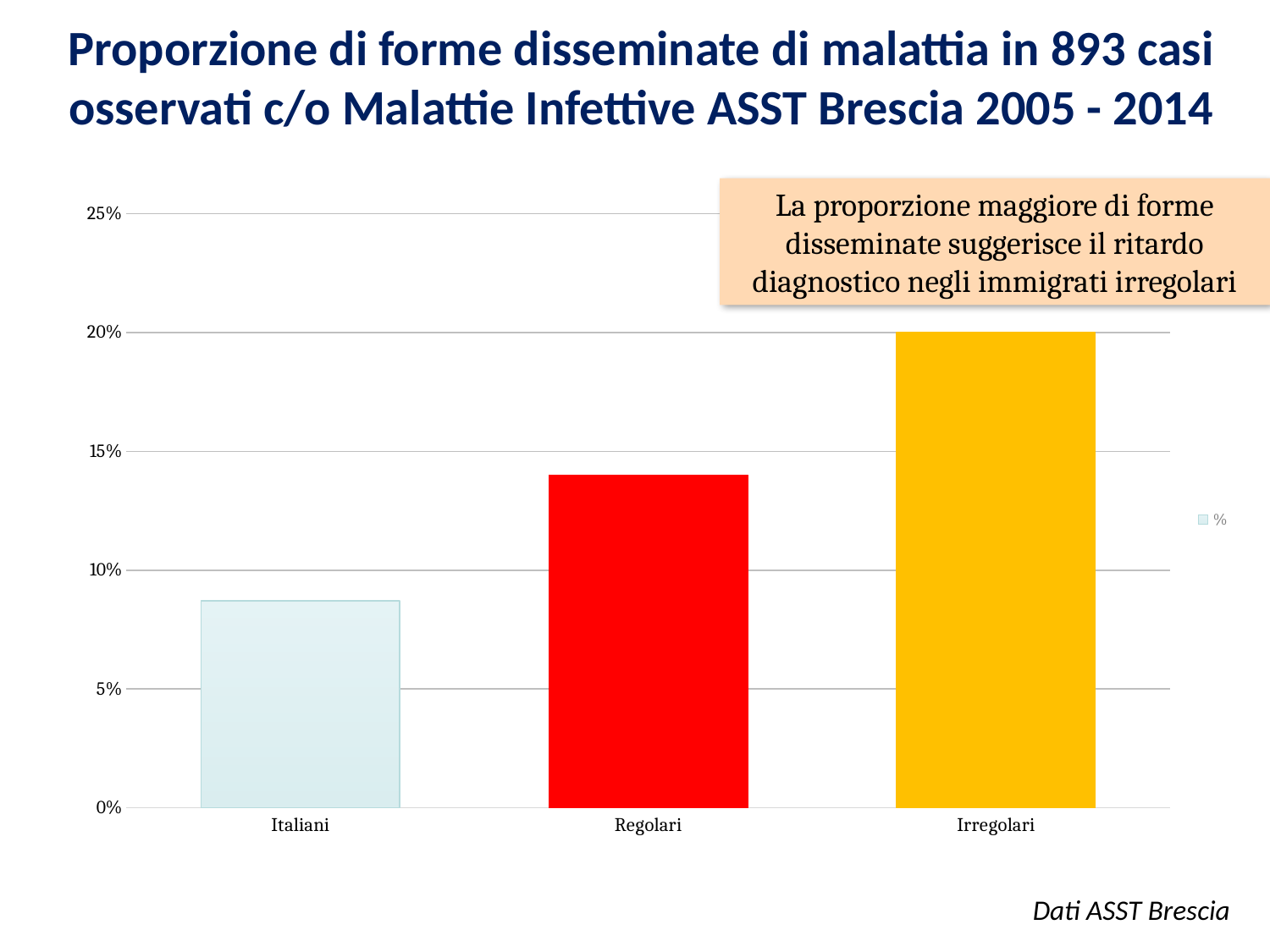
What kind of chart is shown on the slide? bar chart Which is larger, the value for Regolari or the value for Italiani? Regolari What is the value for Irregolari? 20% Do the bar values rise or fall from left to right along the x axis? rise Is the value for Regolari greater or less than 10%? greater Which category has the highest bar? Irregolari How many categories are plotted on the x axis? 3 Is the value for Italiani greater or less than 10%? less Is the value for Regolari greater or less than 15%? less How many series does the legend list? 1 Which category has the lowest bar? Italiani What label does the legend show for the series? %